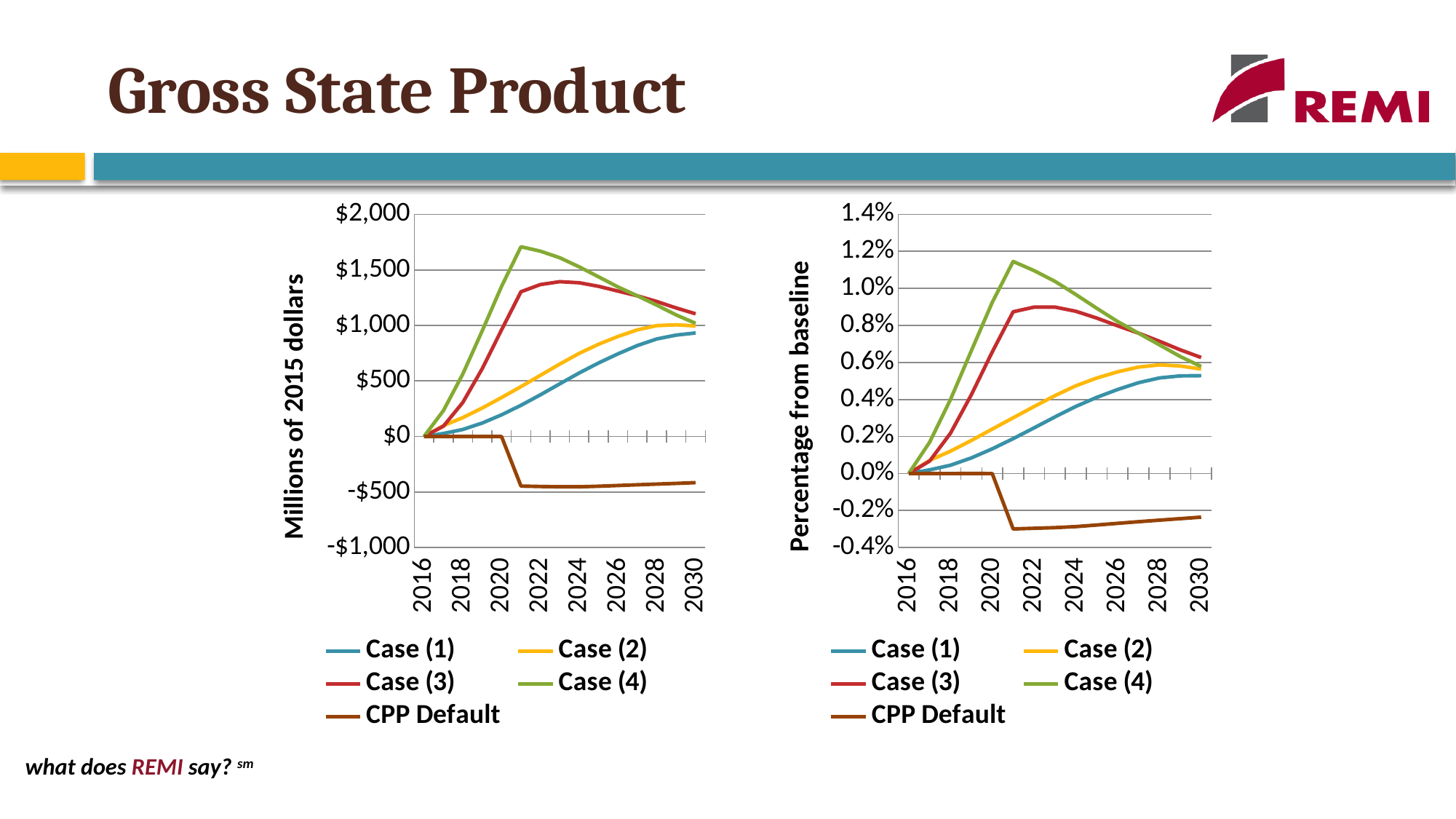
In the right chart (Percentage from baseline), is the peak value for Case (4) greater or less than 1.0%? greater In the left chart (Millions of 2015 dollars), is the peak value for Case (4) greater or less than $1,500? greater What kind of chart is the left chart (Millions of 2015 dollars)? Line chart In the left chart (Millions of 2015 dollars), which series reaches the highest value? Case (4) In the left chart (Millions of 2015 dollars), does the Case (1) line rise or fall from 2016 to 2030? Rise In the right chart (Percentage from baseline), is the value for CPP Default in 2022 greater or less than 0.0%? less In the left chart (Millions of 2015 dollars), which is larger in 2022: Case (4) or Case (3)? Case (4) How many series does the legend of the right chart (Percentage from baseline) list? 5 What is the y-axis label of the right chart? Percentage from baseline In the right chart (Percentage from baseline), which series has the lowest values after 2020? CPP Default In the right chart (Percentage from baseline), which is larger in 2024: Case (2) or Case (1)? Case (2)